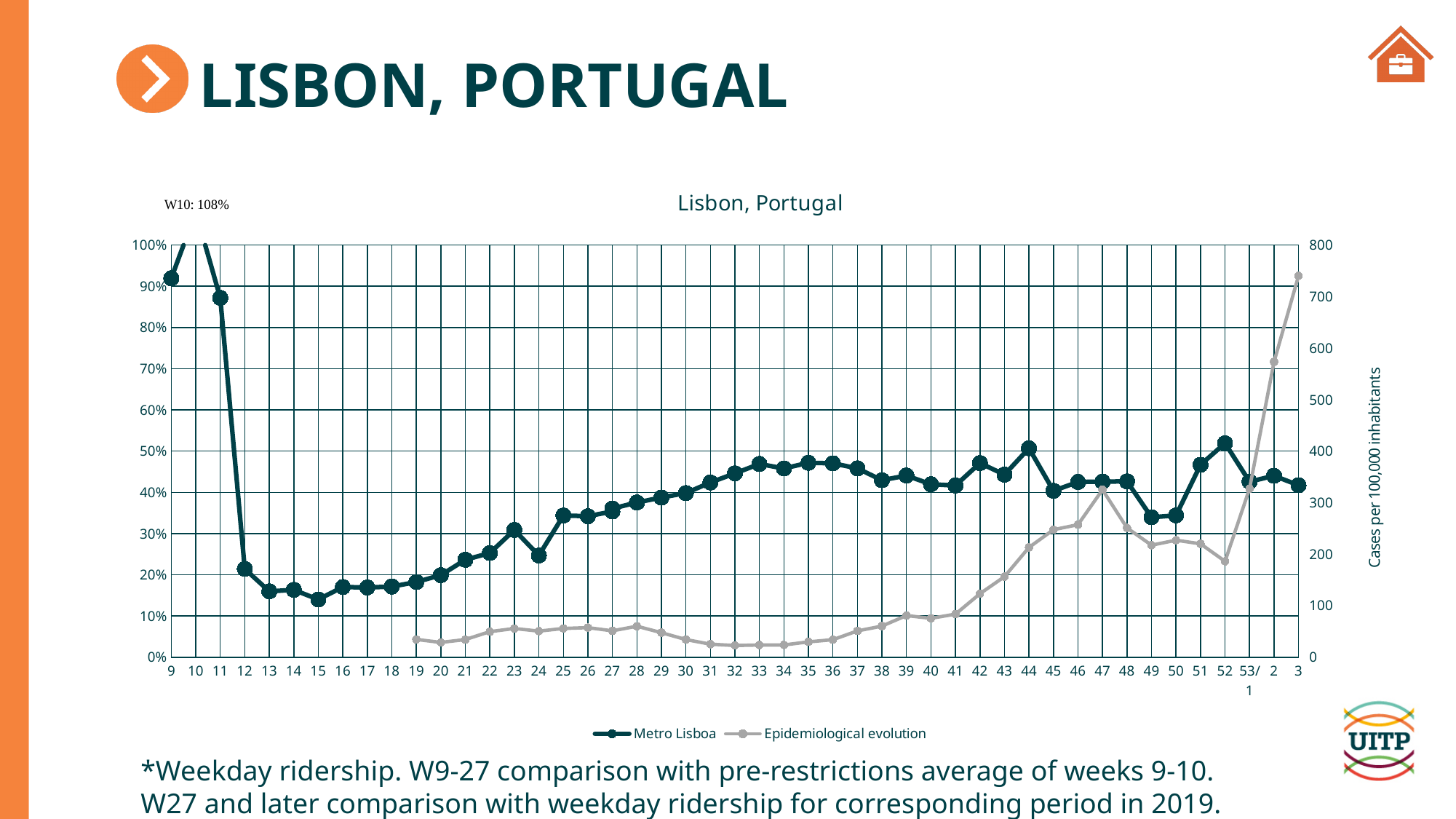
What type of chart is shown on the slide? line chart In which week does the Metro Lisboa series reach its lowest value? 15 What is the title of the chart? Lisbon, Portugal Is the Epidemiological evolution value for week 3 greater or less than 700? greater In which week does the Epidemiological evolution series reach its highest value? 3 What is the label of the right-hand vertical axis? Cases per 100,000 inhabitants What value is annotated for W10 on the chart? 108% Is the Metro Lisboa value for week 15 greater or less than 20%? less Which is larger for Metro Lisboa: the value for week 9 or the value for week 12? week 9 Does the Metro Lisboa series rise or fall between week 12 and week 35? rise Is the Metro Lisboa value for week 9 greater or less than 90%? greater How many series does the legend list? 2